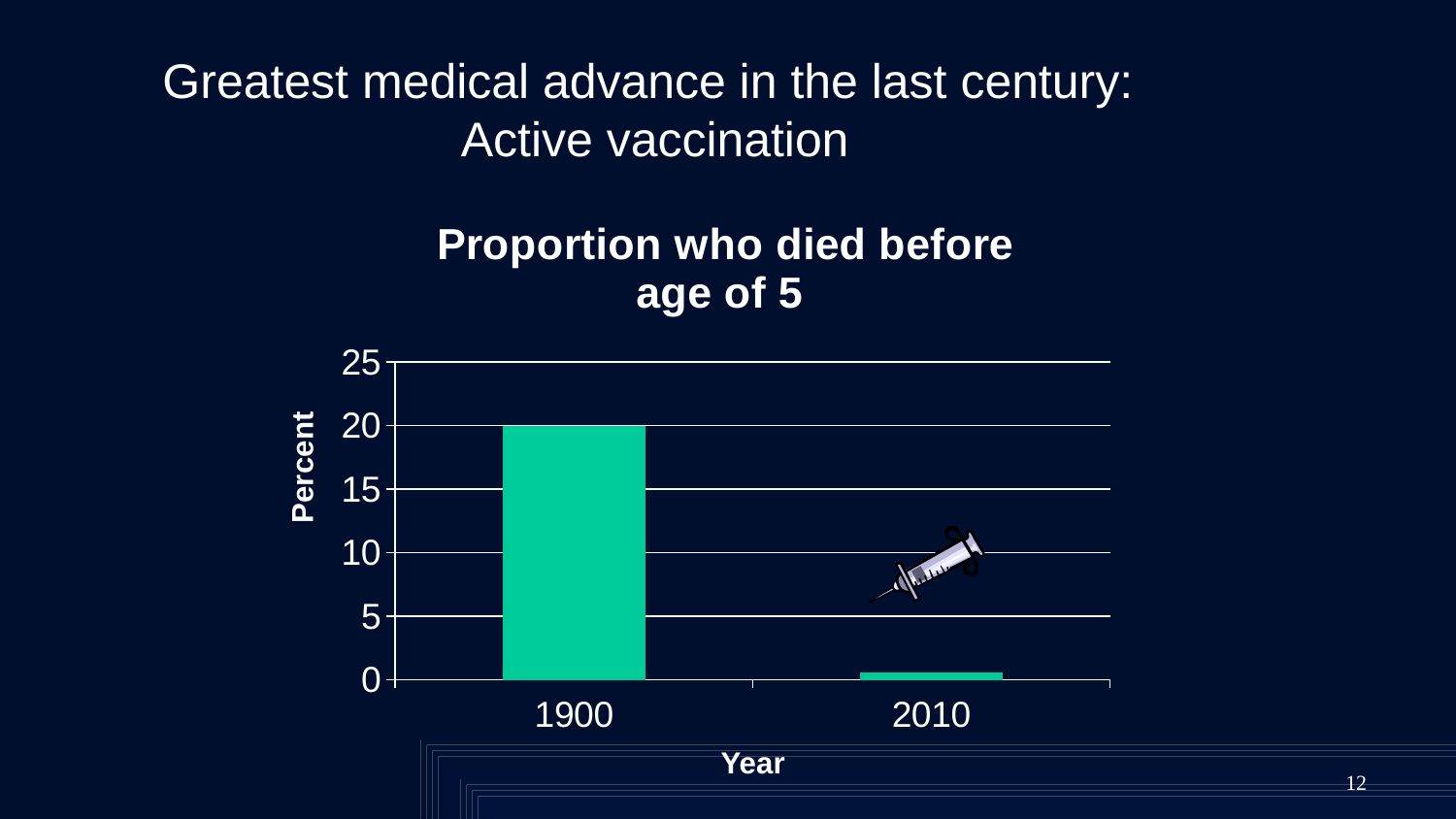
How many years are shown on the x axis of the chart? 2 What is the label of the y axis of the chart? Percent Is the value for 1900 greater or less than 15? greater Do the values rise or fall from 1900 to 2010? fall What is the value for 1900 in the chart? 20 Which year has the lowest value in the chart? 2010 What is the title of the chart? Proportion who died before age of 5 Which is larger, the value for 1900 or the value for 2010? 1900 Is the value for 2010 greater or less than 5? less What kind of chart is shown on the slide? bar chart Which year has the highest value in the chart? 1900